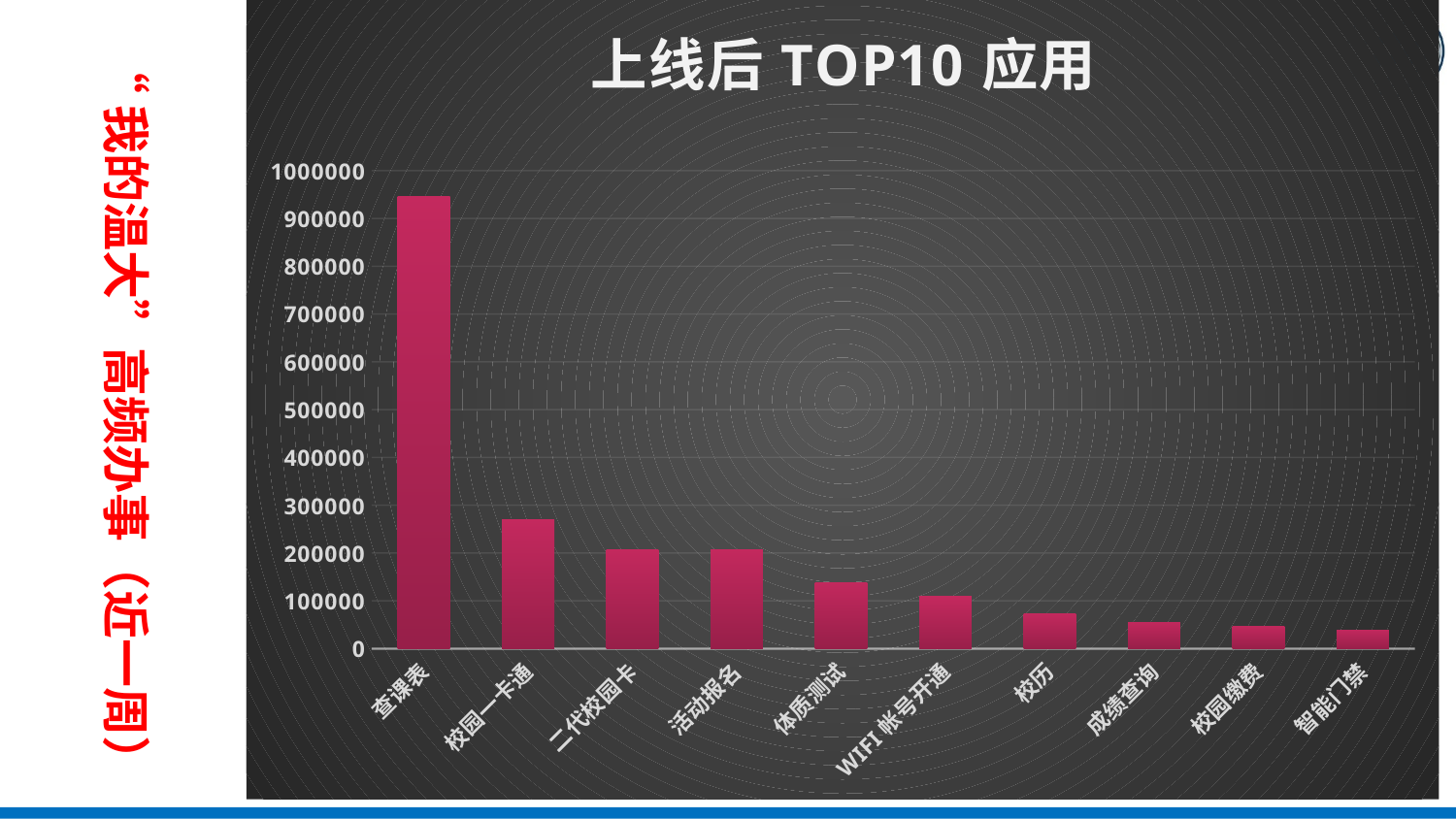
What is the title of the chart? 上线后 TOP10 应用 Do the values rise or fall from left to right along the x axis? fall Which is larger, the value for 校园一卡通 or the value for 体质测试? 校园一卡通 Which is larger, the value for WIFI 帐号开通 or the value for 成绩查询? WIFI 帐号开通 Which category has the highest value? 查课表 Is the value for 校历 greater or less than 100000? less Is the value for 校园一卡通 greater or less than 300000? less Is the value for 查课表 greater or less than 900000? greater What type of chart is shown on the slide? bar chart How many categories are plotted on the x axis? 10